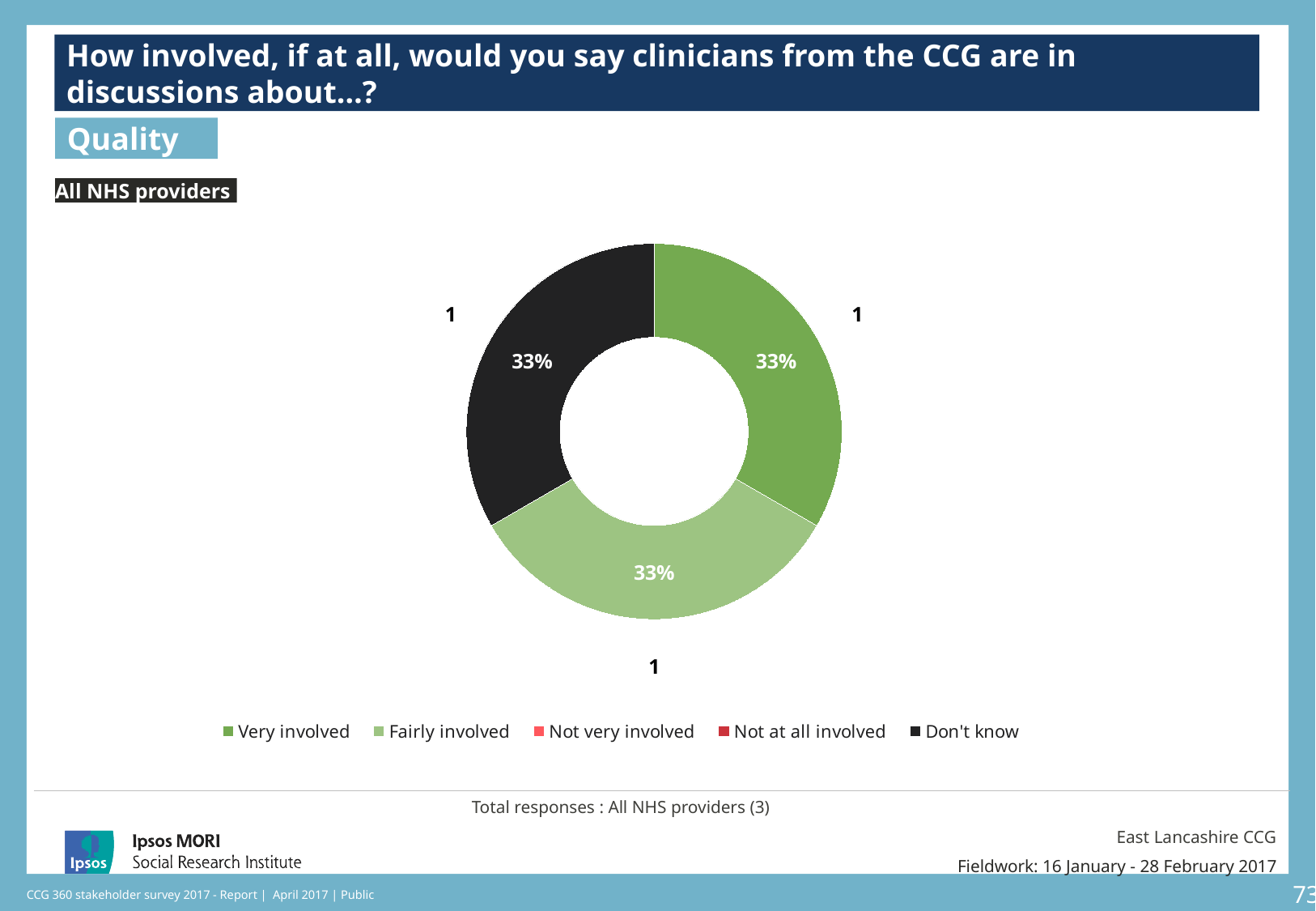
Which topic label appears in the blue box under the question title? Quality How many entries does the legend list? 5 Which legend entry is shown in black? Don't know What percentage of responses is shown for 'Very involved'? 33% What is the total number of responses stated below the chart for All NHS providers? 3 What percentage of responses is shown for 'Fairly involved'? 33% What percentage of responses is shown for 'Don't know'? 33% How many responses does the 'Very involved' slice represent, according to the count label next to it? 1 What kind of chart is shown on the slide? Doughnut (pie) chart How many responses does the 'Don't know' slice represent, according to the count label next to it? 1 How many slices are plotted in the doughnut chart? 3 What is the difference between the percentage for 'Very involved' and the percentage for 'Don't know'? 0%